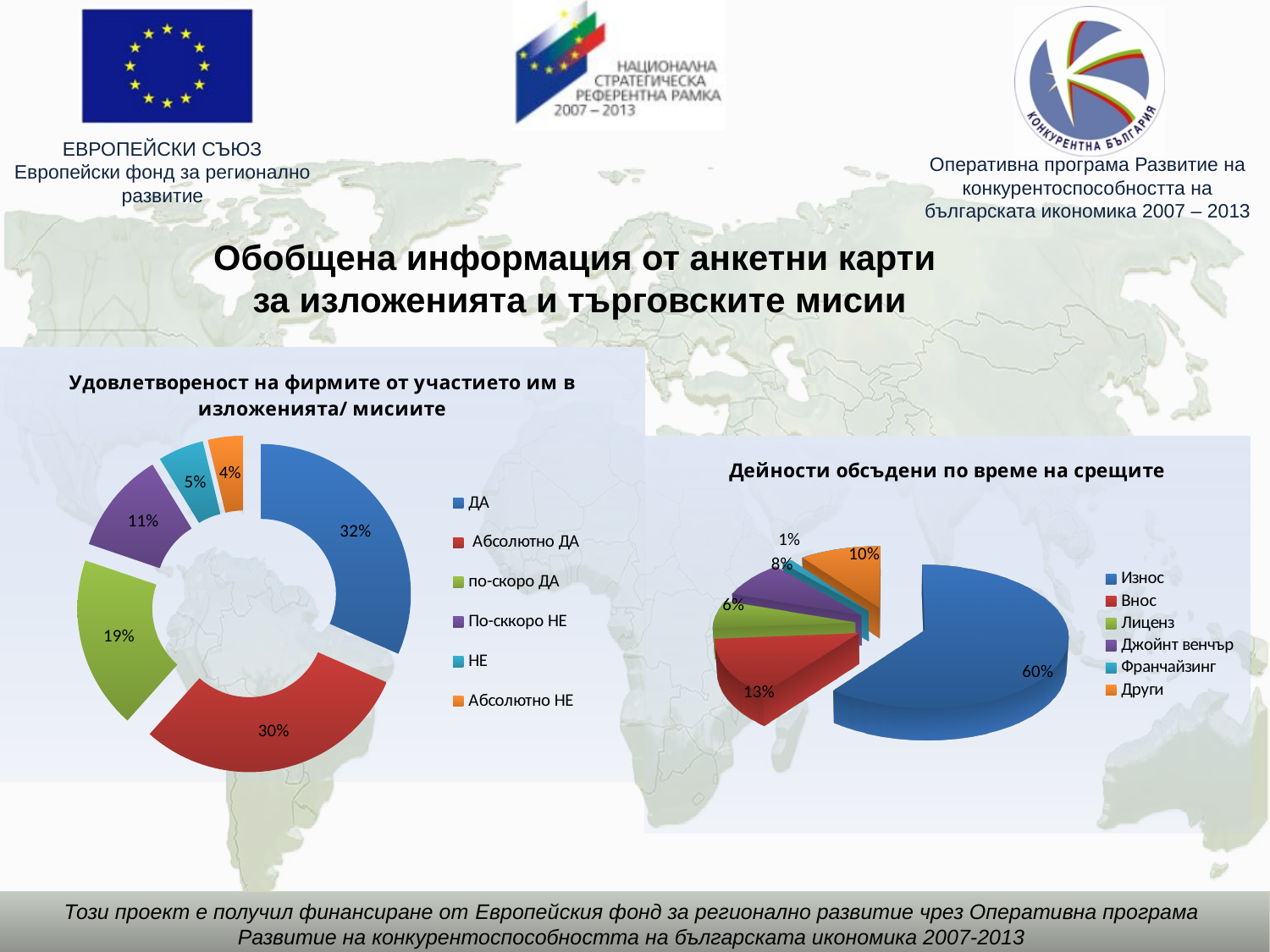
In the chart 'Дейности обсъдени по време на срещите', which category has the smallest share? Франчайзинг In the chart 'Дейности обсъдени по време на срещите', what colour is the slice for 'Други'? Orange In the chart 'Дейности обсъдени по време на срещите', what percentage is shown for 'Износ'? 60% In the chart 'Удовлетвореност на фирмите от участието им в изложенията/ мисиите', what is the difference between the shares for 'Абсолютно ДА' and 'По-сккоро НЕ'? 19% In the chart 'Дейности обсъдени по време на срещите', which category has the largest share? Износ In the chart 'Удовлетвореност на фирмите от участието им в изложенията/ мисиите', what percentage is shown for 'по-скоро ДА'? 19% In the chart 'Удовлетвореност на фирмите от участието им в изложенията/ мисиите', how many categories does the legend list? 6 In the chart 'Удовлетвореност на фирмите от участието им в изложенията/ мисиите', which category has the smallest share? Абсолютно НЕ What type of chart is 'Удовлетвореност на фирмите от участието им в изложенията/ мисиите'? Doughnut chart In the chart 'Дейности обсъдени по време на срещите', which is larger: 'Джойнт венчър' or 'Лиценз'? Джойнт венчър In the chart 'Удовлетвореност на фирмите от участието им в изложенията/ мисиите', what percentage is shown for 'ДА'? 32% In the chart 'Дейности обсъдени по време на срещите', what percentage is shown for 'Внос'? 13%